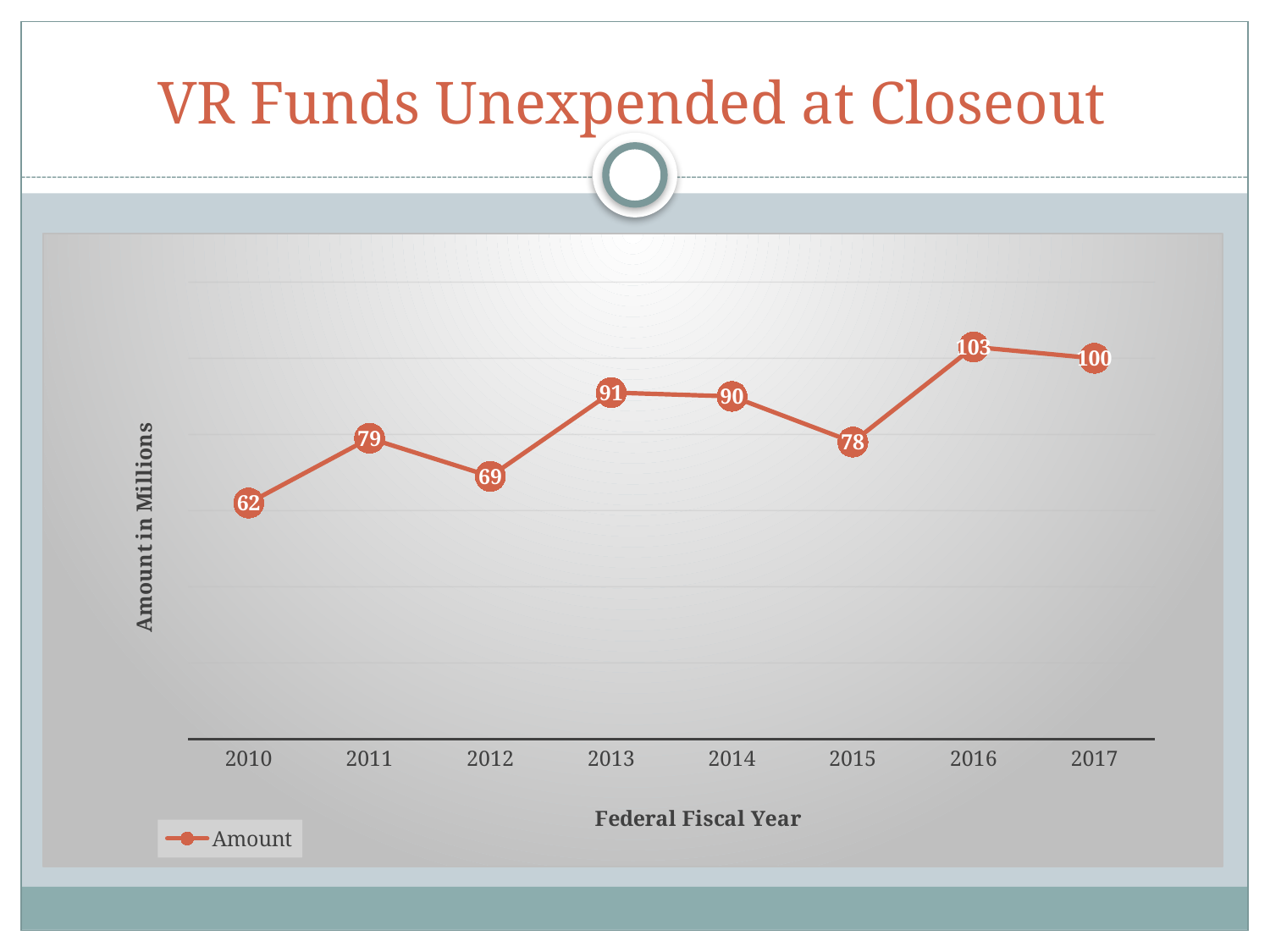
Which federal fiscal year has the lowest amount of VR funds unexpended at closeout? 2010 What is the difference between the amounts for 2011 and 2012? 10 Which year has a larger amount, 2014 or 2015? 2014 What is the amount of VR funds unexpended at closeout for federal fiscal year 2013? 91 Which federal fiscal year has the highest amount of VR funds unexpended at closeout? 2016 What is the amount of VR funds unexpended at closeout for federal fiscal year 2010? 62 How many federal fiscal years are plotted on the chart? 8 What is the amount of VR funds unexpended at closeout for federal fiscal year 2017? 100 What is the label of the y axis? Amount in Millions How many series does the legend list? 1 What kind of chart is shown on the slide? Line chart What is the difference between the amounts for 2016 and 2015? 25